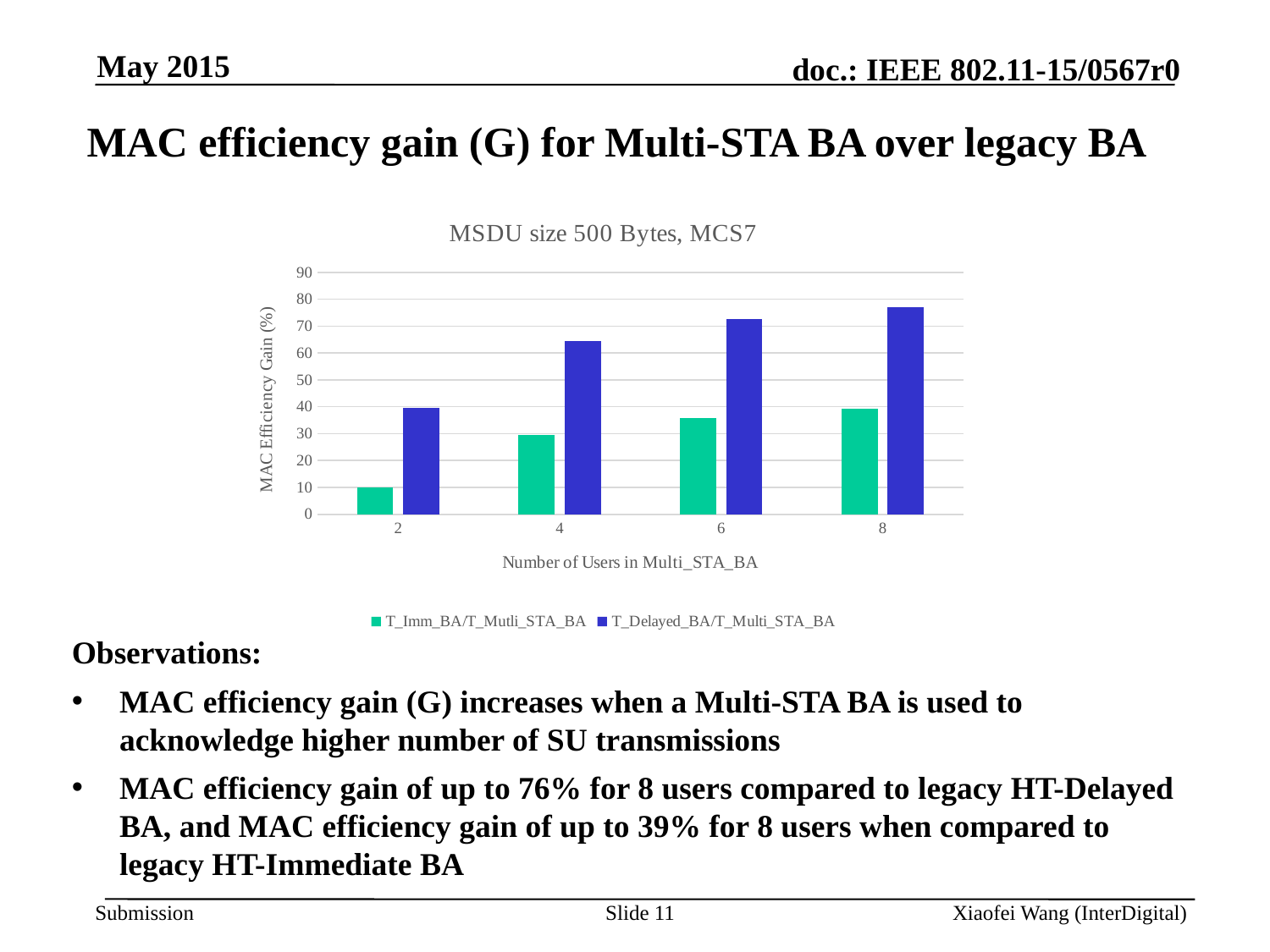
For which number of users is the T_Delayed_BA/T_Multi_STA_BA value highest? 8 Is the T_Delayed_BA/T_Multi_STA_BA value for 4 users greater or less than 60? greater Do the T_Delayed_BA/T_Multi_STA_BA values rise or fall as the number of users increases from 2 to 8? rise At 4 users, which series has the larger value, T_Imm_BA/T_Mutli_STA_BA or T_Delayed_BA/T_Multi_STA_BA? T_Delayed_BA/T_Multi_STA_BA What is the title of the chart? MSDU size 500 Bytes, MCS7 How many categories (numbers of users) are shown on the x axis? 4 How many series does the chart legend list? 2 Is the T_Imm_BA/T_Mutli_STA_BA value for 2 users greater or less than 20? less What kind of chart is shown on the slide? bar chart Is the T_Delayed_BA/T_Multi_STA_BA value for 8 users greater or less than 70? greater What is the label of the y axis? MAC Efficiency Gain (%) For which number of users is the T_Imm_BA/T_Mutli_STA_BA value lowest? 2